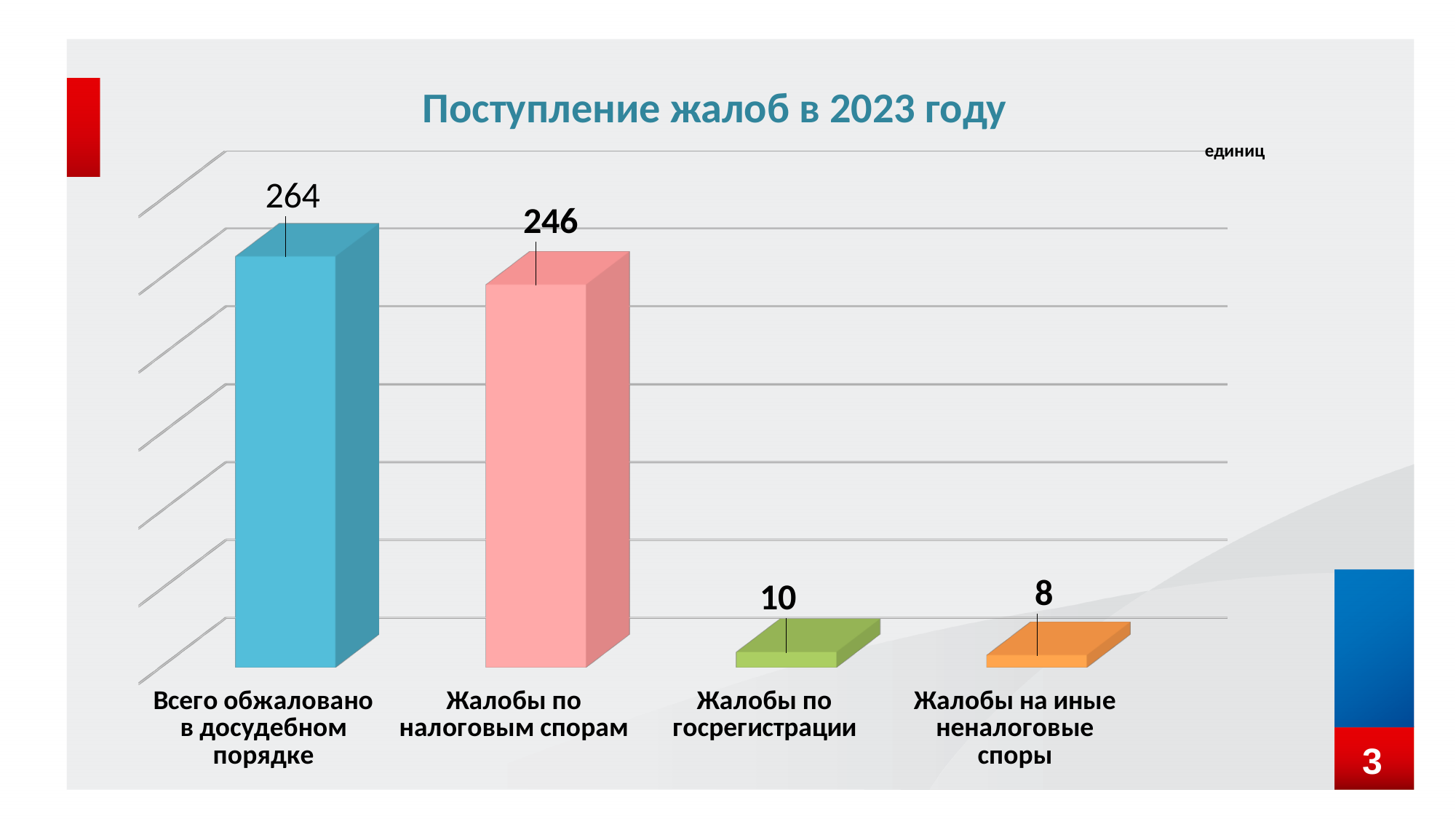
What is the value for "Жалобы на иные неналоговые споры"? 8 Which is larger: "Жалобы по налоговым спорам" or "Жалобы по госрегистрации"? Жалобы по налоговым спорам Which category has the highest value? Всего обжаловано в досудебном порядке Which category has the lowest value? Жалобы на иные неналоговые споры How many categories are shown in the chart? 4 What is the difference between "Всего обжаловано в досудебном порядке" and "Жалобы по налоговым спорам"? 18 What is the value for "Жалобы по налоговым спорам"? 246 What kind of chart is shown on the slide? Bar chart What is the difference between "Жалобы по госрегистрации" and "Жалобы на иные неналоговые споры"? 2 What is the title of the chart? Поступление жалоб в 2023 году What is the value for "Жалобы по госрегистрации"? 10 What is the value for "Всего обжаловано в досудебном порядке"? 264